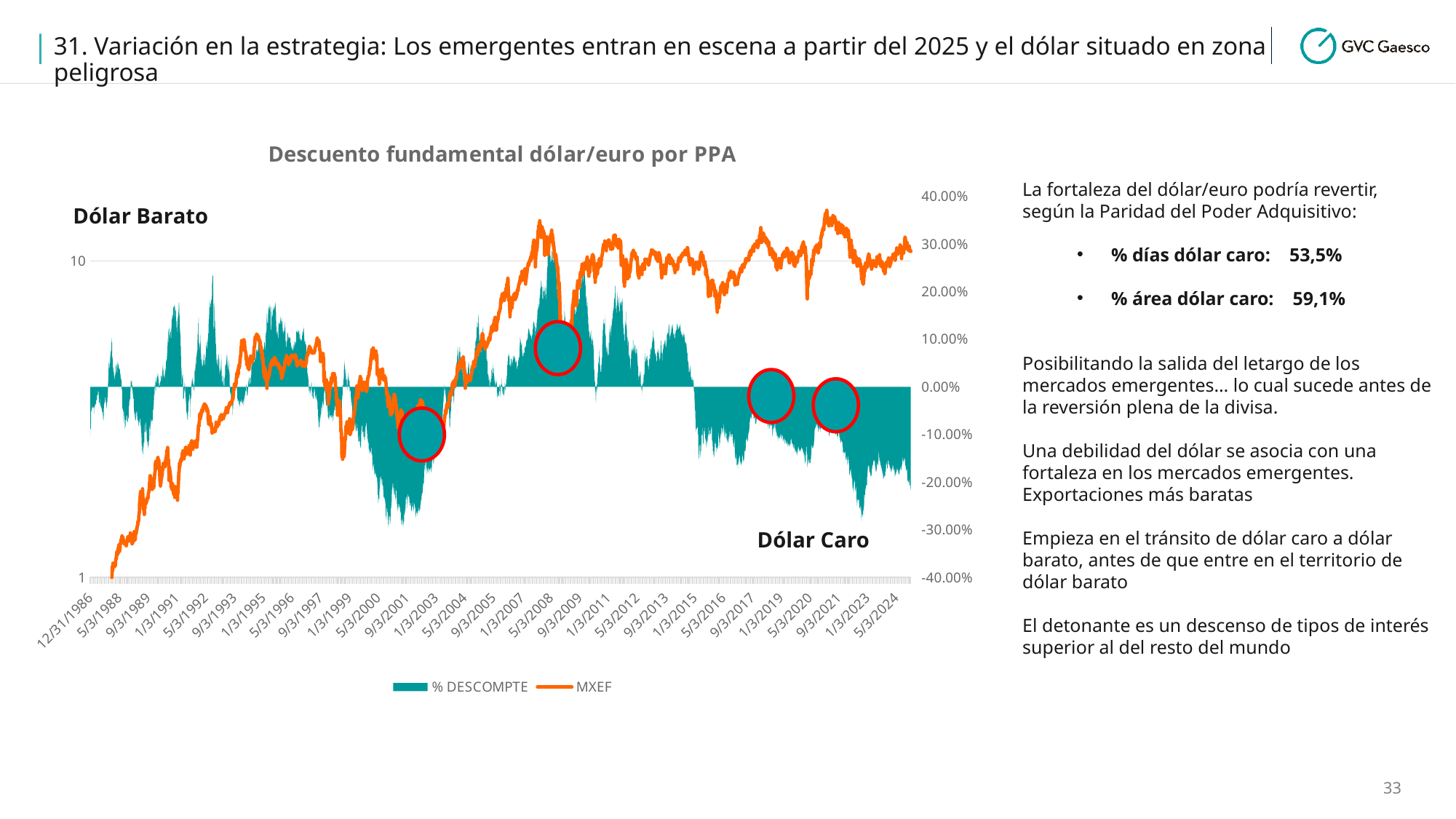
Does the % DESCOMPTE series rise or fall from 1/3/2015 to 5/3/2024? fall Is the value of % DESCOMPTE around 5/3/2008 greater or less than 20.00%? greater Does the MXEF series rise or fall overall from 12/31/1986 to 5/3/2024? rise Is the value of % DESCOMPTE around 5/3/2024 greater or less than -10.00%? less Is the value of % DESCOMPTE around 1/3/2011 greater or less than 0.00%? greater What are the two series named in the chart legend? % DESCOMPTE and MXEF What is the title of the chart? Descuento fundamental dólar/euro por PPA What kind of chart is shown on the slide? Combination area and line chart Which series is plotted as the orange line, % DESCOMPTE or MXEF? MXEF How many series does the chart legend list? 2